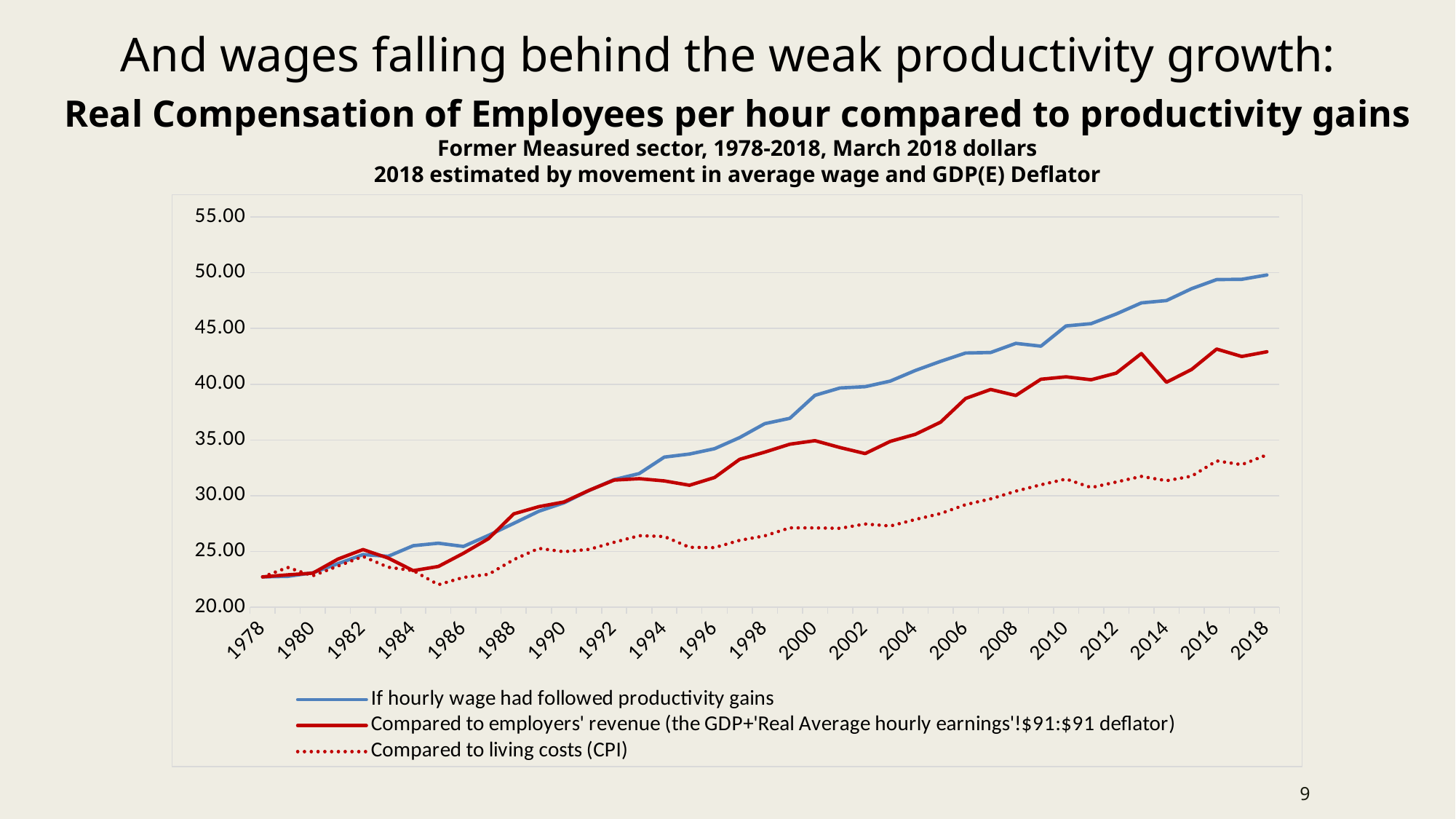
What is the first year shown on the x axis? 1978 Is the value for 'Compared to living costs (CPI)' in 2000 greater or less than 30.00? less In 2010, which is larger: the 'Compared to employers' revenue' series or the 'Compared to living costs (CPI)' series? Compared to employers' revenue Does the 'If hourly wage had followed productivity gains' series rise or fall from 1978 to 2018? rise Which series has the highest value in 2018? If hourly wage had followed productivity gains Which series has the lowest value in 2018? Compared to living costs (CPI) How many series does the legend list? 3 Is the value for 'Compared to living costs (CPI)' in 2018 greater or less than 35.00? less Is the value for 'Compared to employers' revenue' in 2018 greater or less than 40.00? greater What kind of chart is shown on the slide? line chart Which series is plotted with a dotted line? Compared to living costs (CPI)